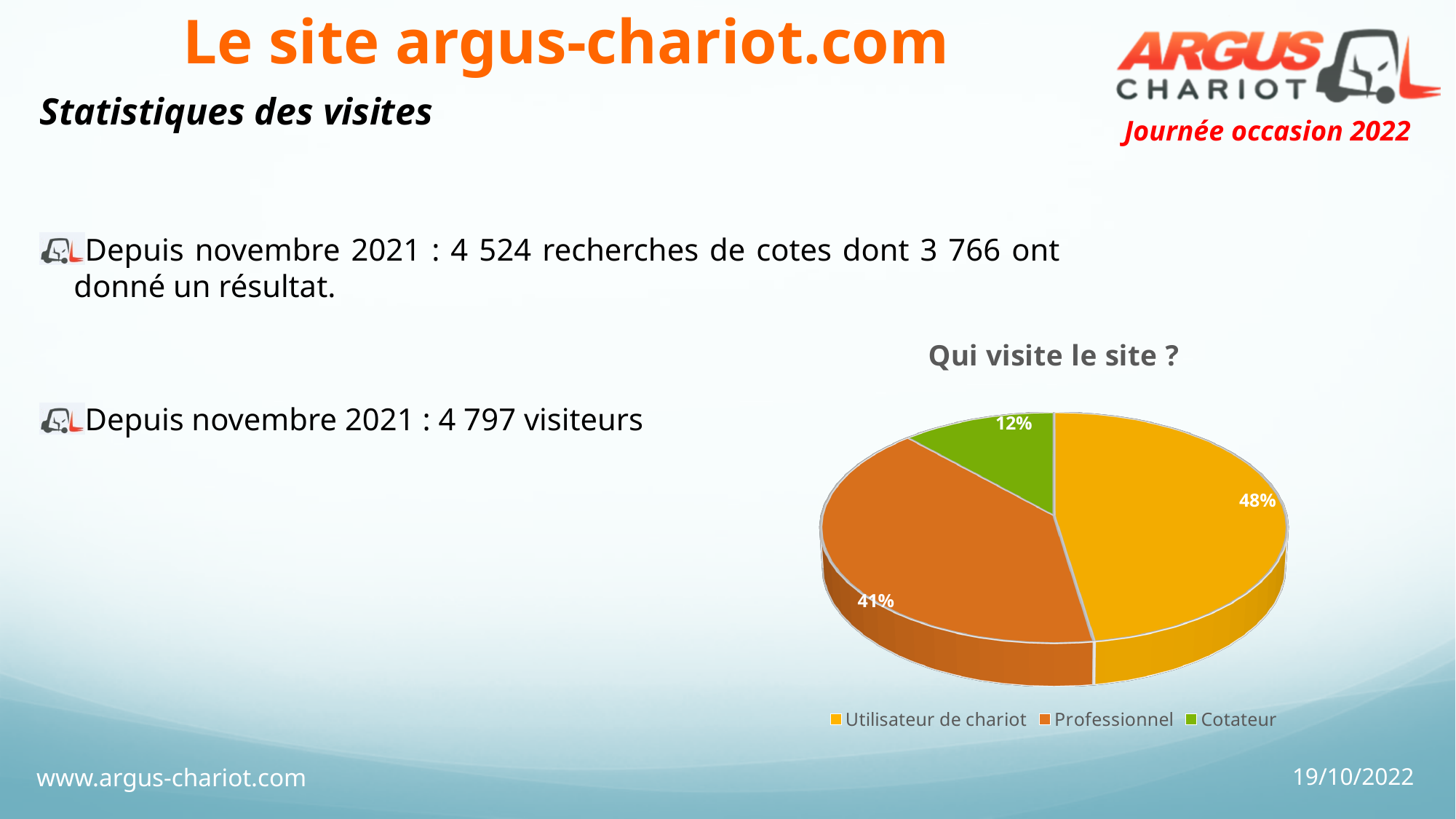
Which category has the largest share of the pie? Utilisateur de chariot What colour is the Cotateur slice in the pie chart? green Which is larger, the share for Professionnel or the share for Cotateur? Professionnel What is the difference in percentage points between Professionnel and Cotateur? 29 What share of the pie is Professionnel? 41% How many categories does the pie chart show? 3 What is the difference in percentage points between Utilisateur de chariot and Professionnel? 7 What share of the pie is Cotateur? 12% Which category has the smallest share of the pie? Cotateur What type of chart is shown on the slide? pie chart What is the title of the chart? Qui visite le site ? What share of the pie is Utilisateur de chariot? 48%